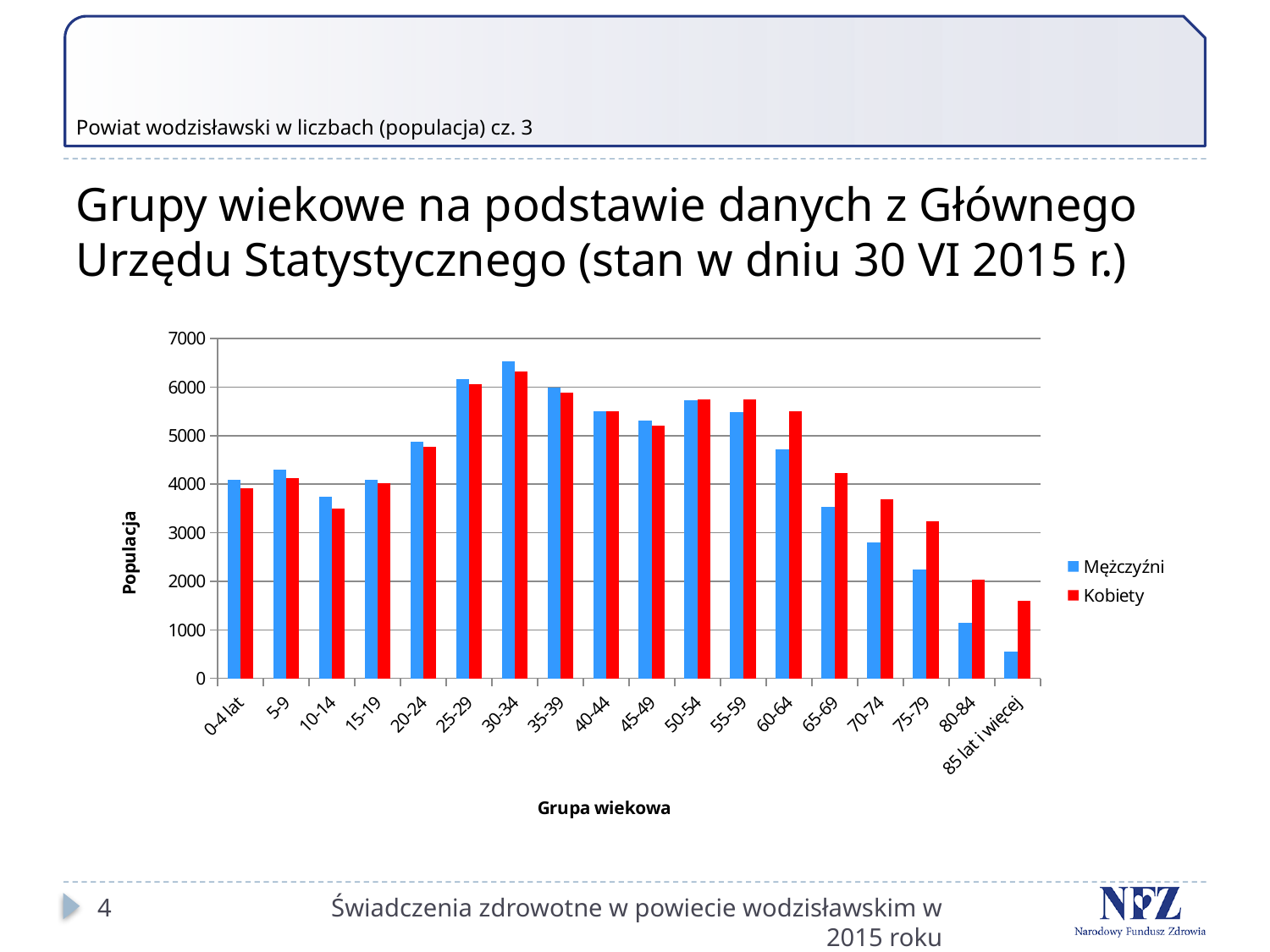
Is the value for Mężczyźni in the 85 lat i więcej group greater or less than 1000? less What kind of chart is shown on the slide? bar chart Which age group has the highest value for Mężczyźni? 30-34 How many series does the legend list? 2 Is the value for Kobiety in the 65-69 group greater or less than 3000? greater From the 60-64 group to the 85 lat i więcej group, do the Mężczyźni values rise or fall? fall Which age group has the lowest value for Mężczyźni? 85 lat i więcej Which age group has the lowest value for Kobiety? 85 lat i więcej In the 60-64 group, which series has the larger value, Mężczyźni or Kobiety? Kobiety Is the value for Mężczyźni in the 70-74 group greater or less than 3000? less How many age groups are shown on the x axis? 18 What is the title of the vertical axis? Populacja